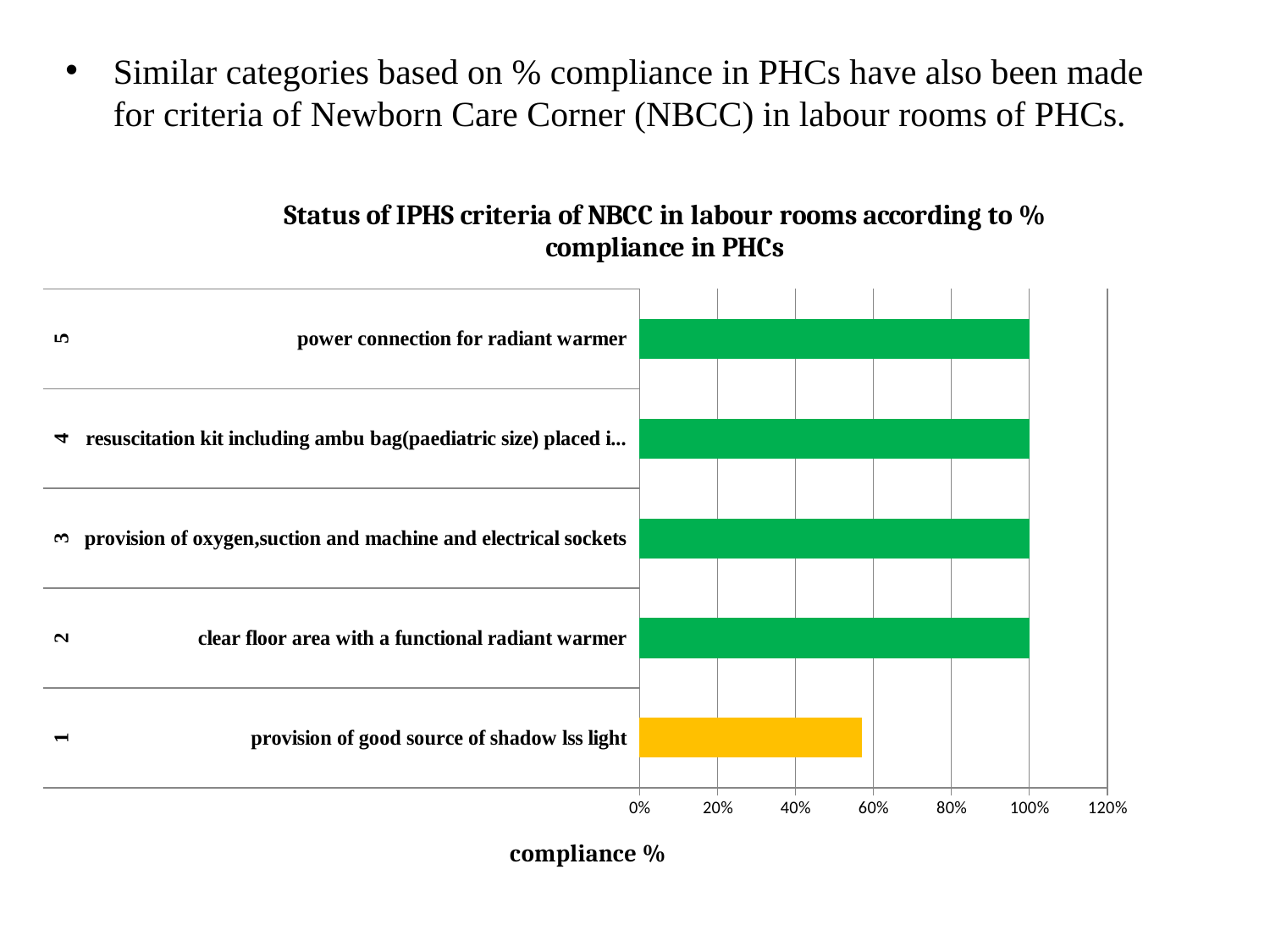
Which criterion has the lowest compliance % in the chart? provision of good source of shadow lss light What is the compliance % for 'power connection for radiant warmer'? 100% What is the title of the chart? Status of IPHS criteria of NBCC in labour rooms according to % compliance in PHCs What is the compliance % for 'clear floor area with a functional radiant warmer'? 100% What is the highest value shown on the horizontal axis of the chart? 120% What is the compliance % for 'provision of oxygen,suction and machine and electrical sockets'? 100% How many criteria (categories) are plotted in the chart? 5 Which criterion's bar is coloured yellow rather than green? provision of good source of shadow lss light What type of chart is shown on the slide? bar chart Which has a higher compliance %: 'power connection for radiant warmer' or 'provision of good source of shadow lss light'? power connection for radiant warmer Is the compliance % for 'provision of good source of shadow lss light' greater or less than 40%? greater Is the compliance % for 'provision of good source of shadow lss light' greater or less than 60%? less